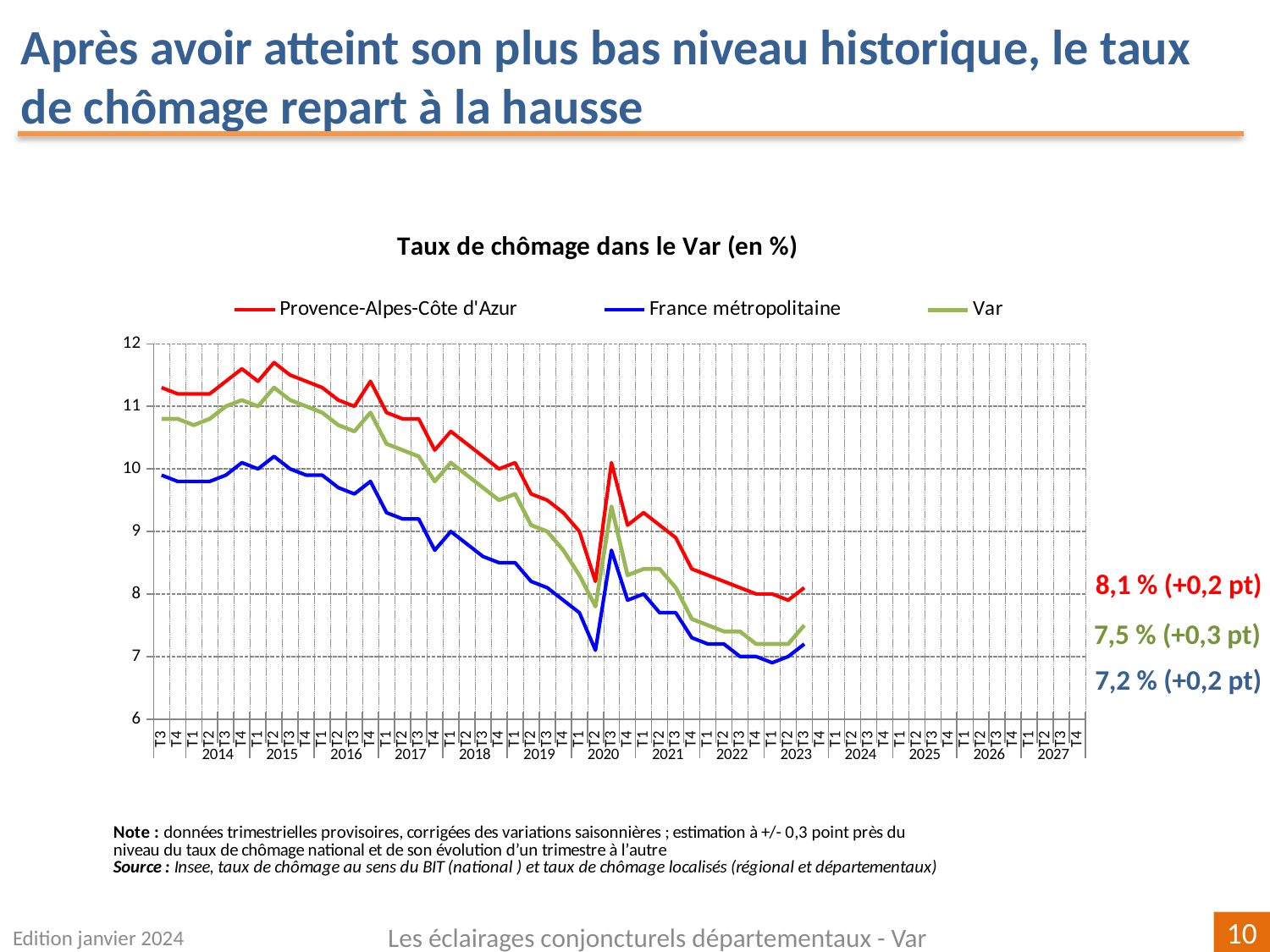
What is the latest unemployment rate shown for Provence-Alpes-Côte d'Azur? 8,1 % Which series has the lowest value at the end of the period? France métropolitaine What is the latest unemployment rate shown for the Var? 7,5 % How many series does the legend list? 3 Overall, does the unemployment rate for the Var rise or fall between 2014 and 2023? fall What is the difference between the latest rates for Provence-Alpes-Côte d'Azur and France métropolitaine? 0,9 pt Is the value for Provence-Alpes-Côte d'Azur in T3 2013 greater or less than 11? greater What is the title of the chart? Taux de chômage dans le Var (en %) What is the latest unemployment rate shown for France métropolitaine? 7,2 % What kind of chart is shown on the slide? line chart Which series is drawn in green? Var Which series has the highest value at the end of the period? Provence-Alpes-Côte d'Azur